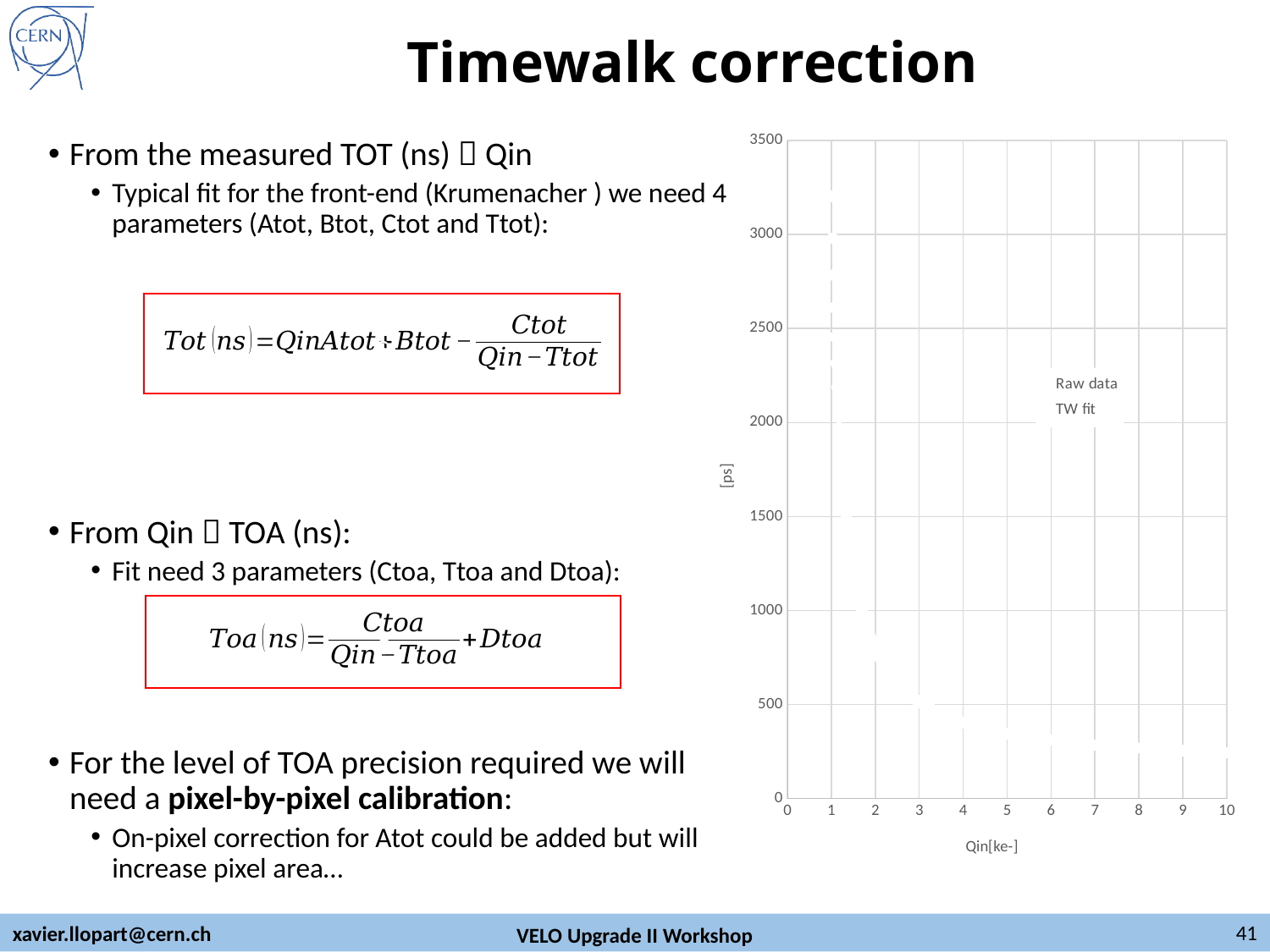
What are the two series named in the chart legend? Raw data and TW fit What kind of chart is shown on the slide? scatter chart Do the plotted values rise or fall as Qin increases along the x axis? fall What is the maximum value shown on the x axis of the chart? 10 How many series does the chart legend list? 2 What is the label of the x axis of the chart? Qin[ke-] What is the maximum value shown on the y axis of the chart? 3500